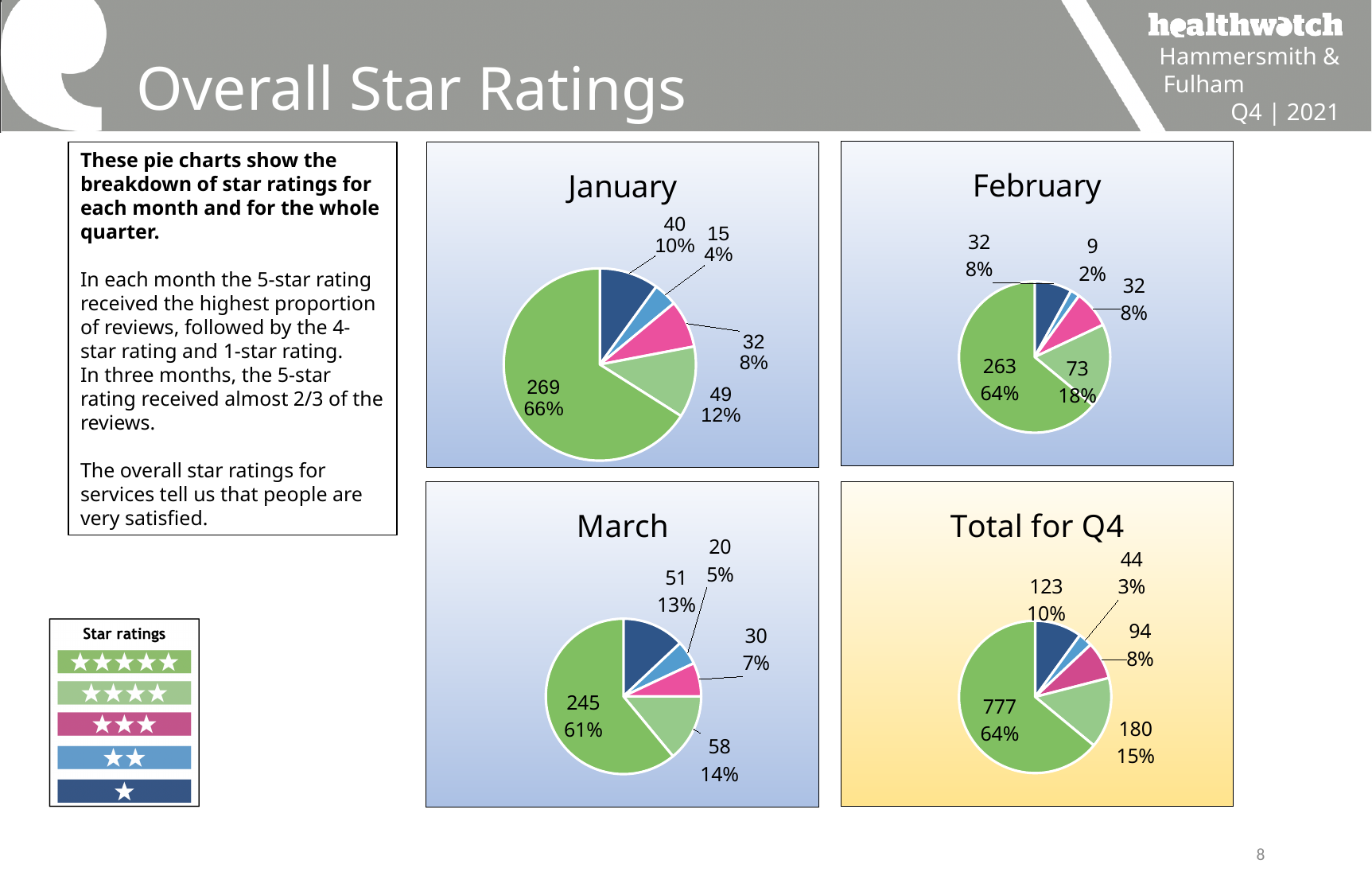
In the Total for Q4 chart, which is larger: the number of 1-star reviews or the number of 3-star reviews? 1-star reviews How many pie charts are shown on the slide? 4 In the March chart, how many reviews gave a 1-star rating? 51 In the Total for Q4 chart, how many reviews gave a 2-star rating? 44 In the February chart, which star rating has the smallest slice? 2-star In the January chart, how many reviews gave a 5-star rating? 269 In the January chart, what is the difference between the number of 5-star reviews and 4-star reviews? 220 In the March chart, which star rating has the largest slice? 5-star In the Total for Q4 chart, what share of reviews gave a 5-star rating? 64% How many slices does the February pie chart have? 5 What type of chart is used for the Total for Q4 data? Pie chart In the February chart, what percentage of reviews gave a 4-star rating? 18%